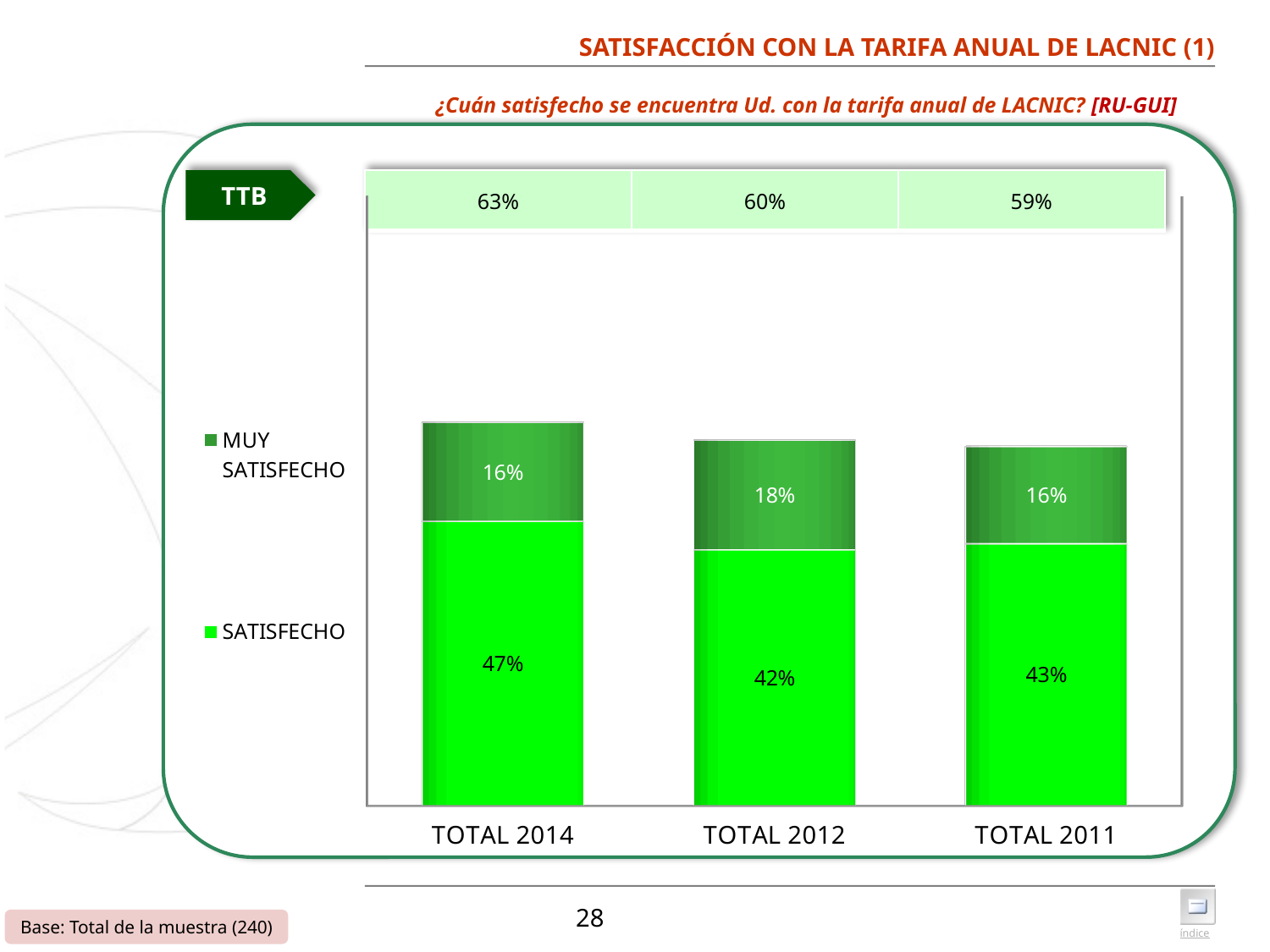
What kind of chart is shown on the slide? Stacked bar chart How many categories are shown on the x axis? 3 Which category has the lowest SATISFECHO value? TOTAL 2012 What is the SATISFECHO value for TOTAL 2011? 43% Which is larger, the MUY SATISFECHO value for TOTAL 2012 or for TOTAL 2011? TOTAL 2012 What is the TTB value shown for TOTAL 2014? 63% What is the total of the stacked bar for TOTAL 2011? 59% What is the MUY SATISFECHO value for TOTAL 2012? 18% What is the SATISFECHO value for TOTAL 2014? 47% Which category has the highest SATISFECHO value? TOTAL 2014 What is the difference between the SATISFECHO values for TOTAL 2014 and TOTAL 2012? 5% How many series does the legend list? 2